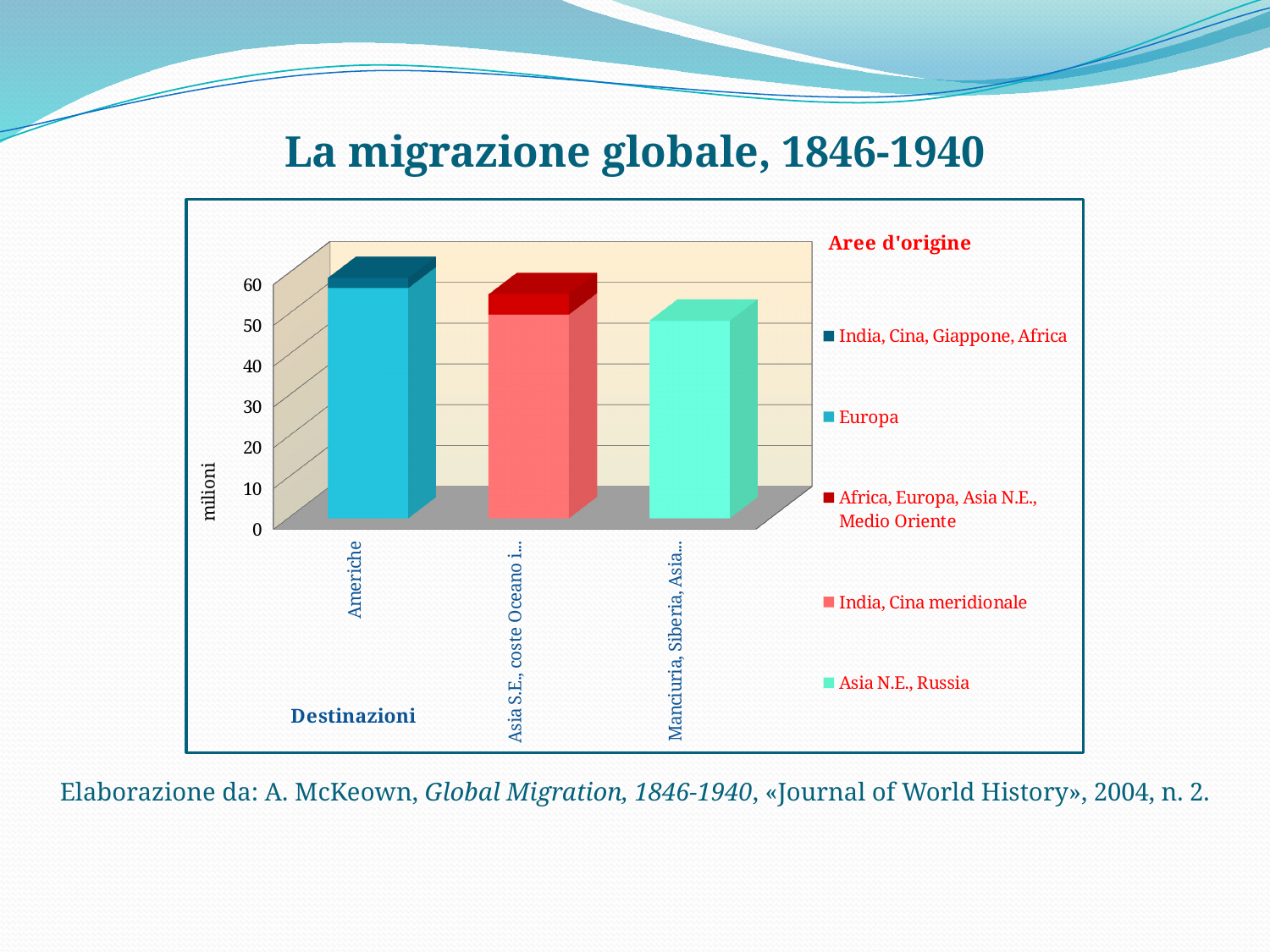
Which bar is taller, Americhe or Manciuria, Siberia, Asia...? Americhe What is the title of the chart? Aree d'origine Is the total for Americhe greater or less than 40? greater How many series does the legend list? 5 What is the label of the vertical axis? milioni How many destination categories are shown on the x axis? 3 Is the total for Manciuria, Siberia, Asia... greater or less than 60? less Which series makes up the largest part of the Americhe bar? Europa What type of chart is shown on the slide? bar chart Which series makes up the Manciuria, Siberia, Asia... bar? Asia N.E., Russia Is the total for Asia S.E., coste Oceano i... greater or less than 30? greater Which destination has the tallest bar? Americhe